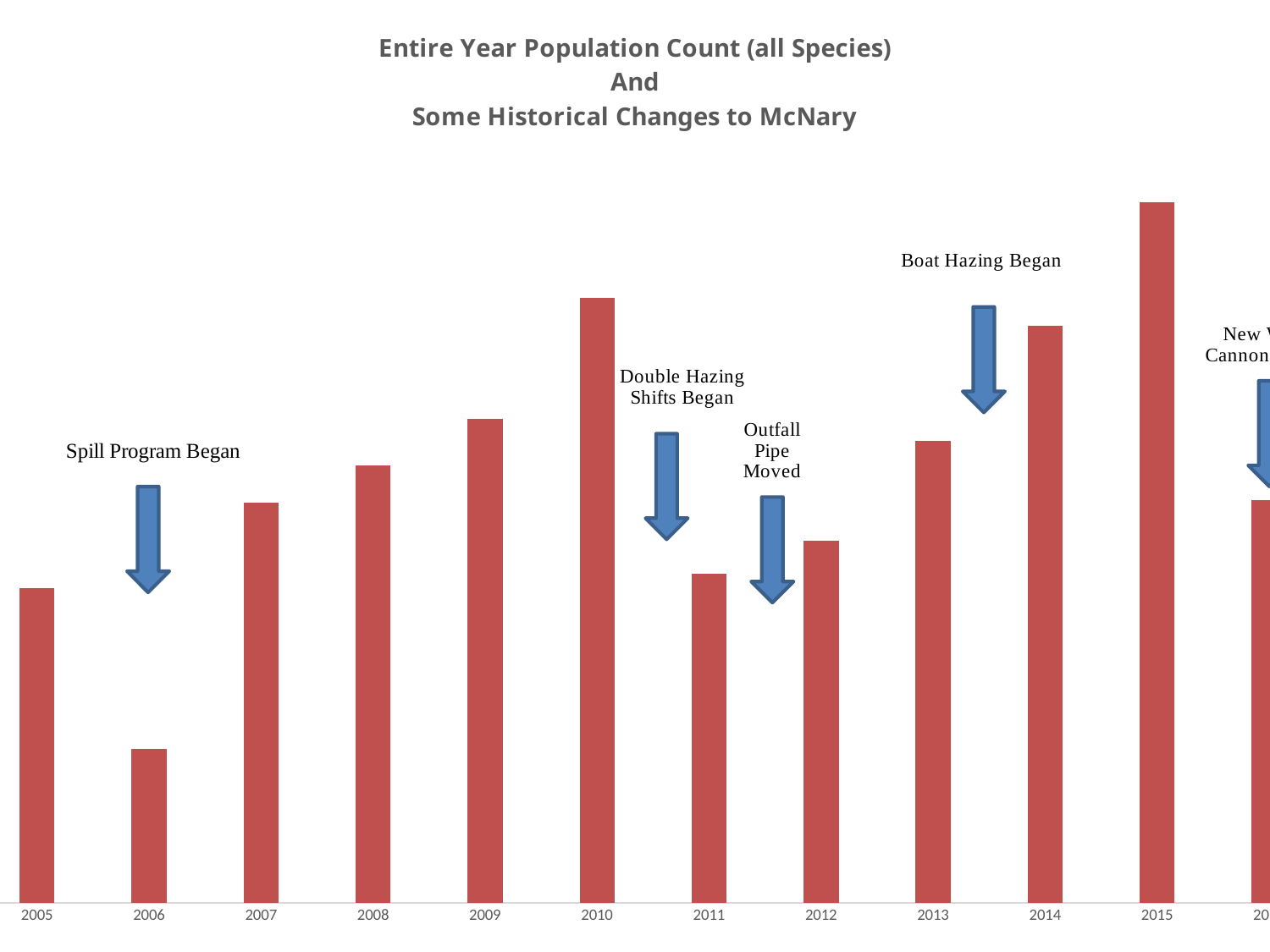
Which year has the lowest population count? 2006 Which year has the larger population count, 2008 or 2009? 2009 Does the population count rise or fall from 2010 to 2011? Fall Which historical change is annotated above the 2006 bar? Spill Program Began What kind of chart is shown on the slide? Bar chart Do the population counts rise or fall from 2012 to 2015? Rise Which year has the larger population count, 2005 or 2007? 2007 Which year has the highest population count? 2015 What is the first year shown on the x axis? 2005 Which year has the larger population count, 2011 or 2012? 2012